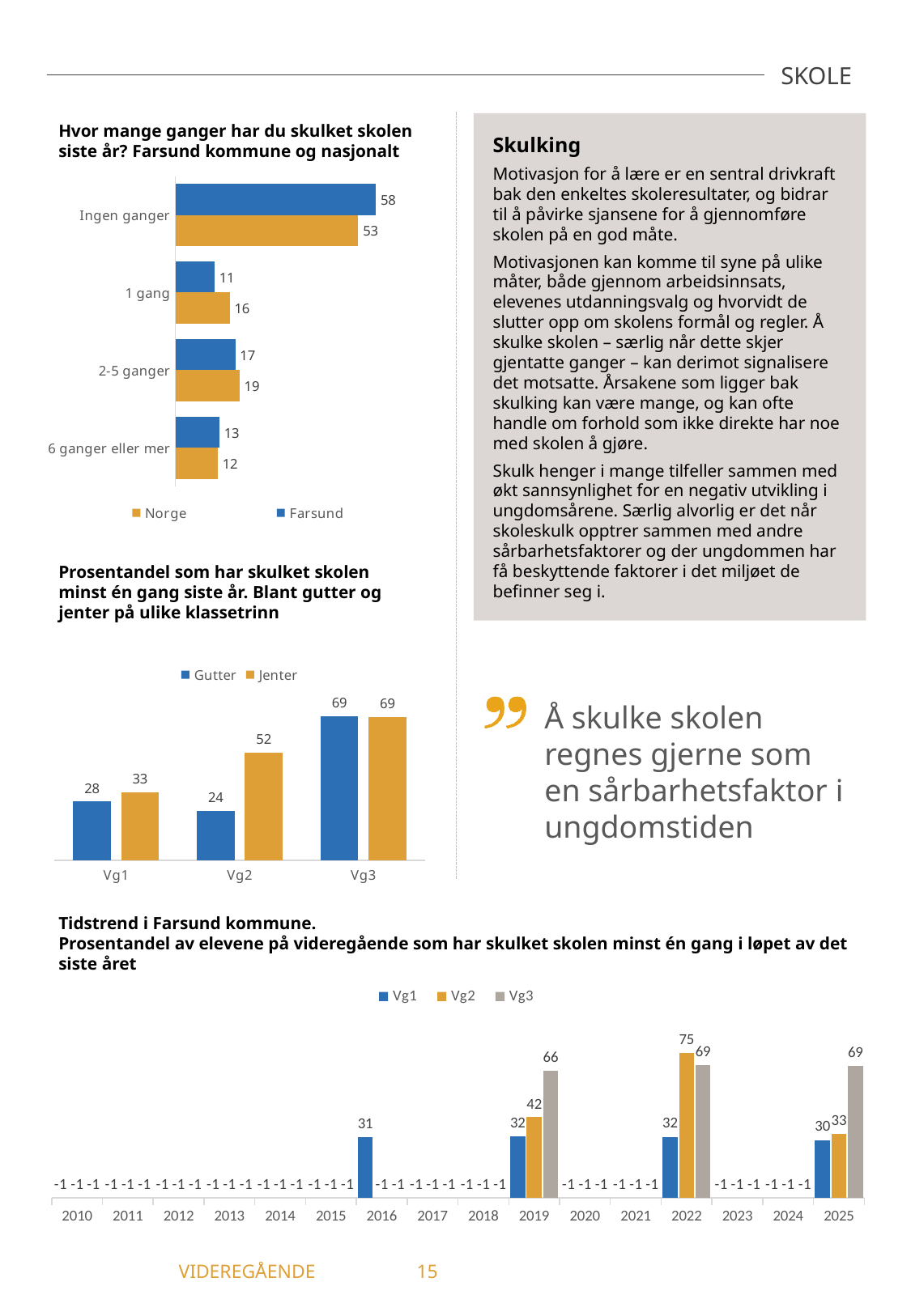
In the chart 'Tidstrend i Farsund kommune', what is the value for Vg2 in 2022? 75 In the chart 'Hvor mange ganger har du skulket skolen siste år?', what is the value for Norge in the category '1 gang'? 16 In the chart 'Hvor mange ganger har du skulket skolen siste år?', how many series does the legend list? 2 In the chart 'Tidstrend i Farsund kommune', what is the difference between Vg3 and Vg1 in 2019? 34 In the chart 'Prosentandel som har skulket skolen minst én gang siste år', which is larger at Vg1: Gutter or Jenter? Jenter In the chart 'Hvor mange ganger har du skulket skolen siste år?', what is the value for Farsund in the category 'Ingen ganger'? 58 In the chart 'Prosentandel som har skulket skolen minst én gang siste år', which class level has the lowest value for Gutter? Vg2 In the chart 'Prosentandel som har skulket skolen minst én gang siste år', what is the value for Jenter at Vg2? 52 In the chart 'Hvor mange ganger har du skulket skolen siste år?', which category has the highest value for Farsund? Ingen ganger In the chart 'Tidstrend i Farsund kommune', how many series does the legend list? 3 What kind of chart is 'Prosentandel som har skulket skolen minst én gang siste år'? Bar chart In the chart 'Hvor mange ganger har du skulket skolen siste år?', what is the difference between Norge and Farsund for '2-5 ganger'? 2